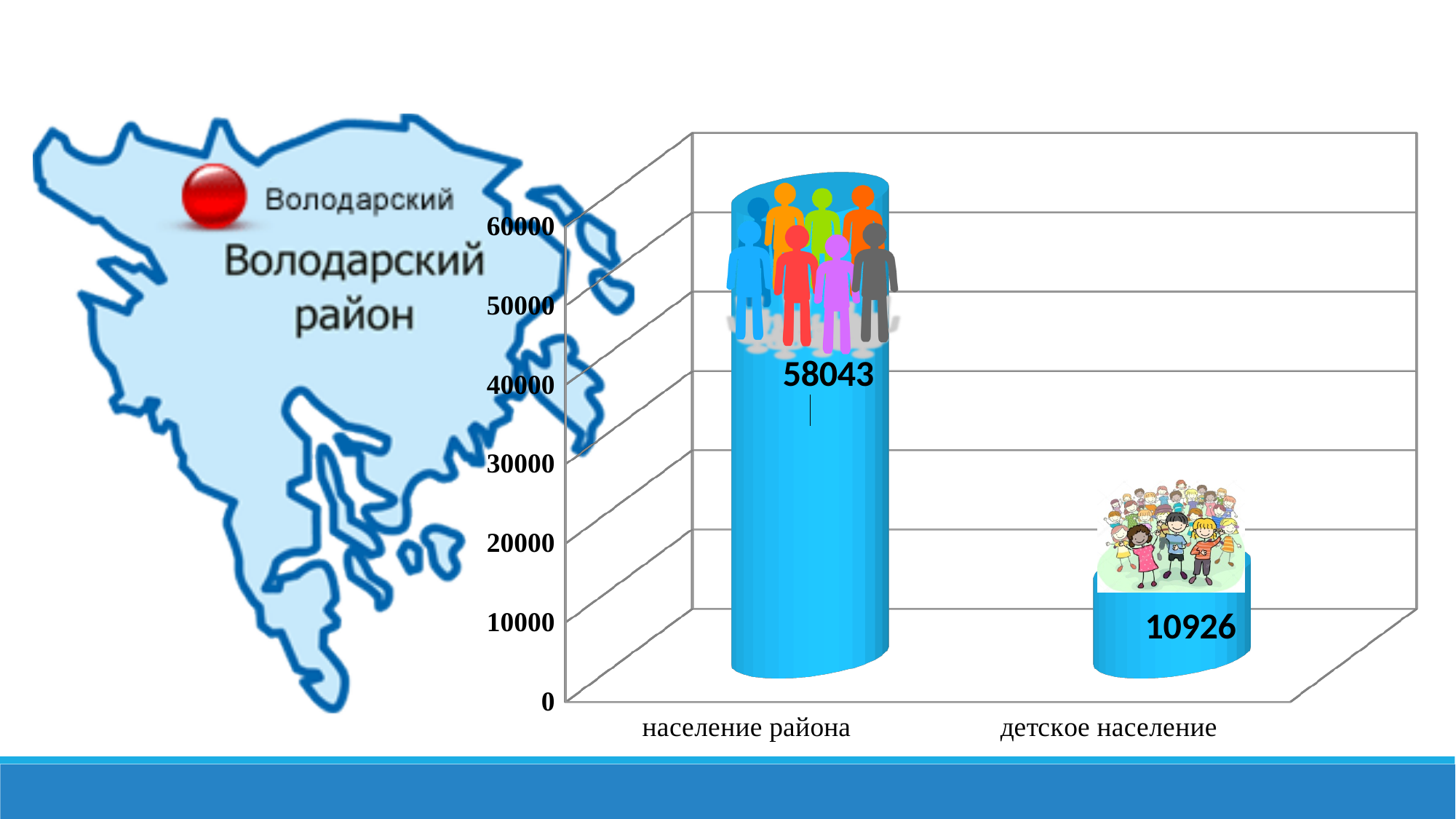
Which is larger, население района or детское население? население района How many categories are shown on the chart? 2 Which category has the highest value? население района Which category has the lowest value? детское население What kind of chart is shown on the slide? bar chart Is the value for детское население greater or less than 20000? less What is the value for население района? 58043 What is the name of the district shown on the map next to the chart? Володарский район What is the difference between население района and детское население? 47117 What is the value for детское население? 10926 Is the value for население района greater or less than 50000? greater What is the highest value shown on the vertical axis? 60000